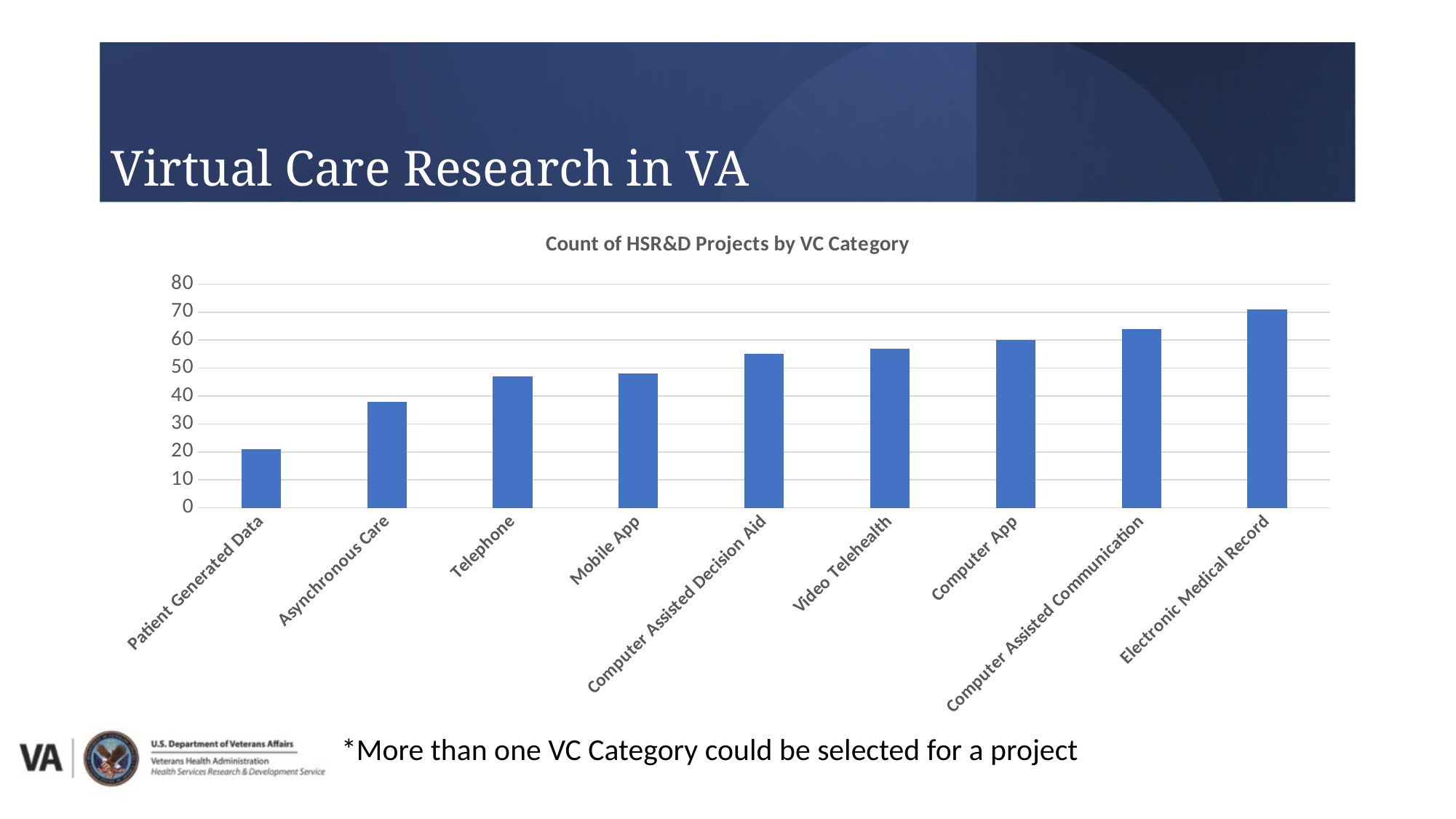
What kind of chart is shown on the slide? bar chart Is the value for Video Telehealth greater or less than 50? greater Is the value for Computer Assisted Communication greater or less than 60? greater Which has a higher count, Telephone or Computer Assisted Decision Aid? Computer Assisted Decision Aid What is the title of the chart? Count of HSR&D Projects by VC Category Do the values rise or fall from left to right across the categories? rise How many VC categories are shown on the chart? 9 Which VC category has the lowest count of HSR&D projects? Patient Generated Data Which VC category has the highest count of HSR&D projects? Electronic Medical Record Is the value for Asynchronous Care greater or less than 40? less